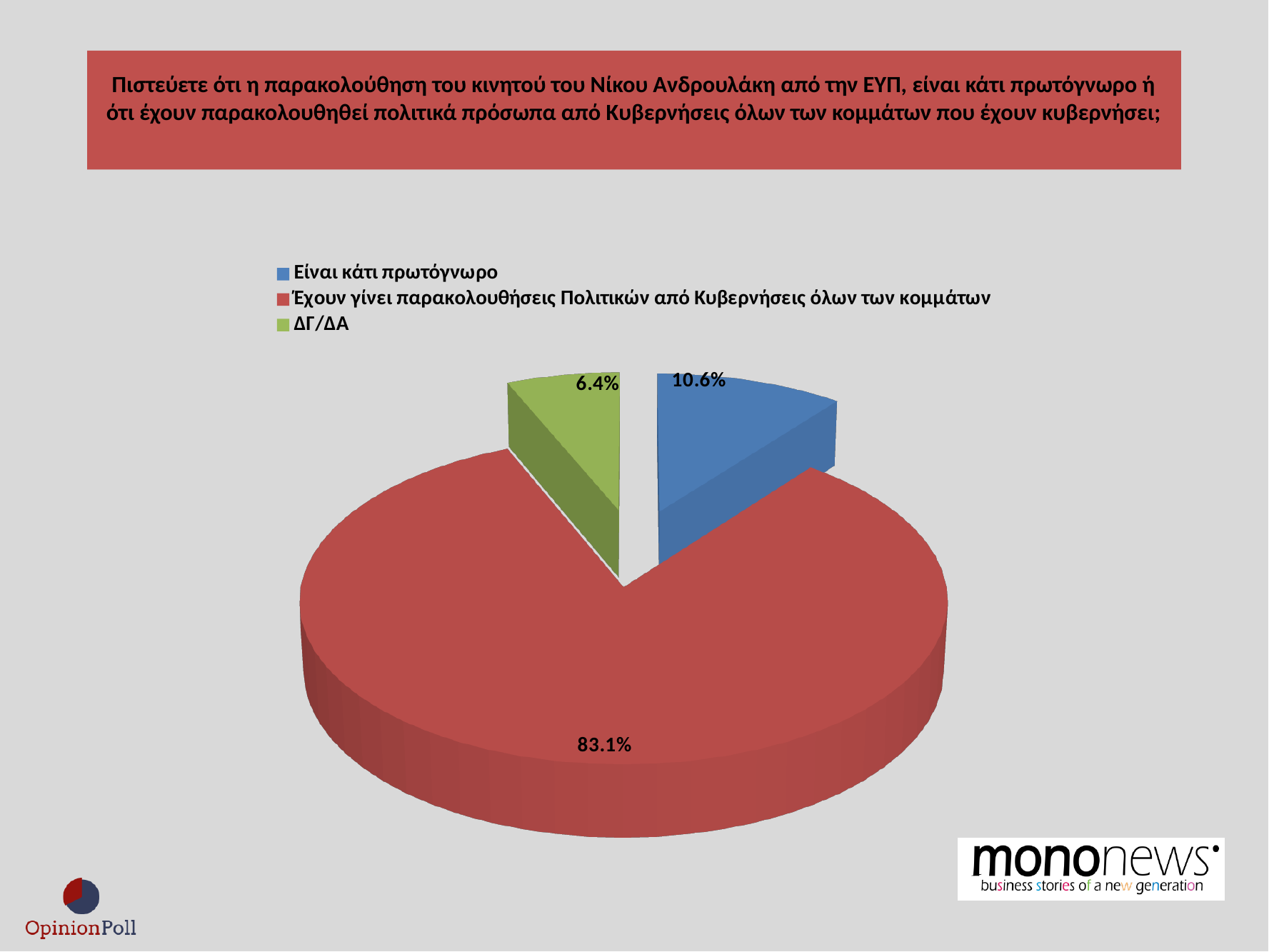
What is the difference in percentage points between "Έχουν γίνει παρακολουθήσεις Πολιτικών από Κυβερνήσεις όλων των κομμάτων" and "Είναι κάτι πρωτόγνωρο"? 72.5 How many slices does the pie chart have? 3 Which category has the smallest slice of the pie? ΔΓ/ΔΑ What colour is the slice for "ΔΓ/ΔΑ"? Green What percentage is shown for "ΔΓ/ΔΑ"? 6.4% What percentage is shown for "Είναι κάτι πρωτόγνωρο"? 10.6% How many entries does the legend list? 3 What kind of chart is shown on the slide? Pie chart What is the difference in percentage points between "Είναι κάτι πρωτόγνωρο" and "ΔΓ/ΔΑ"? 4.2 What percentage is shown for "Έχουν γίνει παρακολουθήσεις Πολιτικών από Κυβερνήσεις όλων των κομμάτων"? 83.1% Which is larger, the slice for "Είναι κάτι πρωτόγνωρο" or the slice for "ΔΓ/ΔΑ"? Είναι κάτι πρωτόγνωρο Which category has the largest slice of the pie? Έχουν γίνει παρακολουθήσεις Πολιτικών από Κυβερνήσεις όλων των κομμάτων